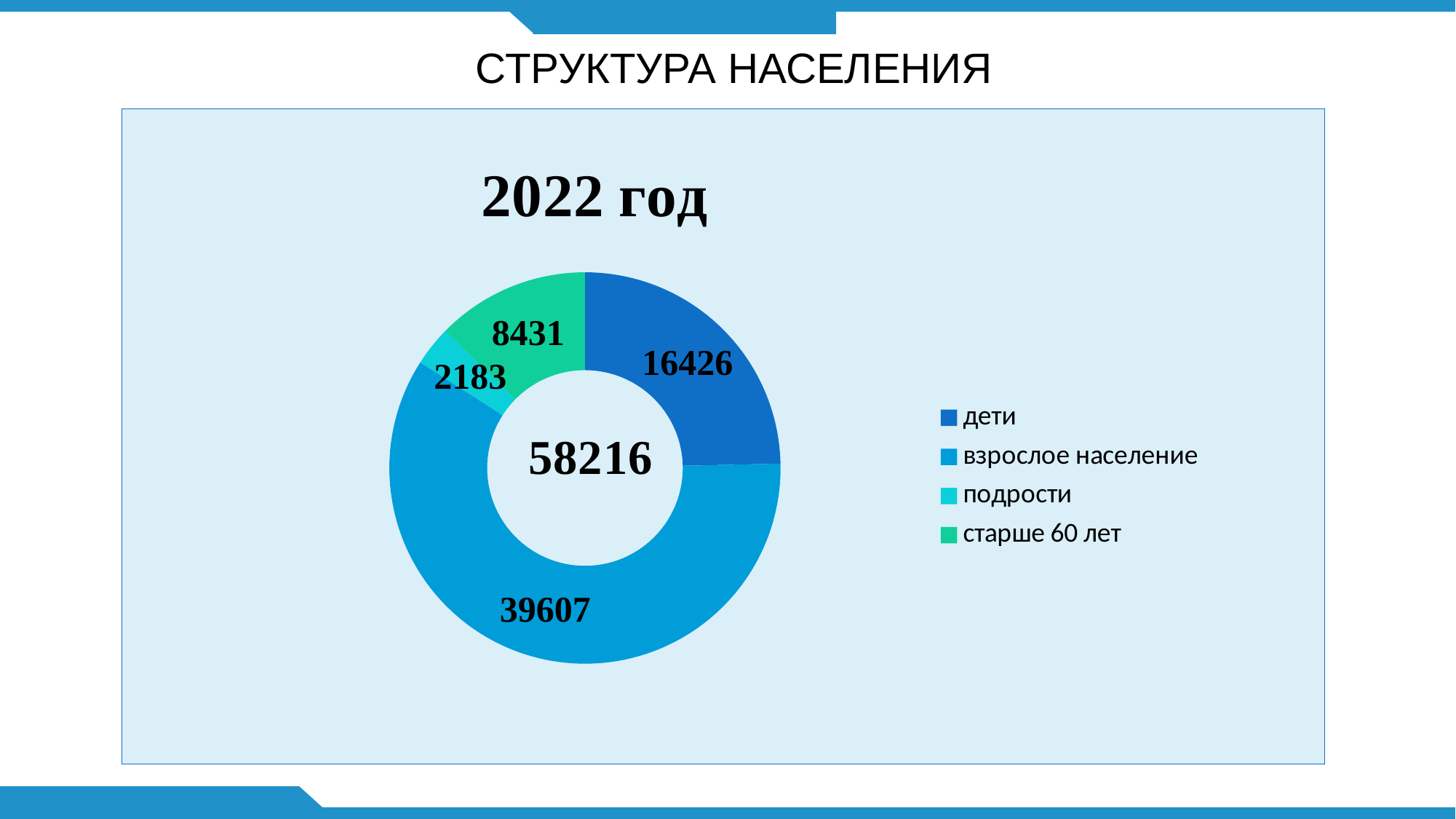
What is the value for подрости? 2183 What number is printed in the centre of the doughnut chart? 58216 What is the value for старше 60 лет? 8431 Which is larger: дети or старше 60 лет? дети What is the difference between старше 60 лет and подрости? 6248 What is the value for взрослое население? 39607 What kind of chart is shown on the slide? Doughnut (pie) chart Which category has the smallest value? подрости Which category has the largest value? взрослое население What is the value for дети in the 2022 год chart? 16426 What is the difference between взрослое население and дети? 23181 How many categories does the chart show? 4